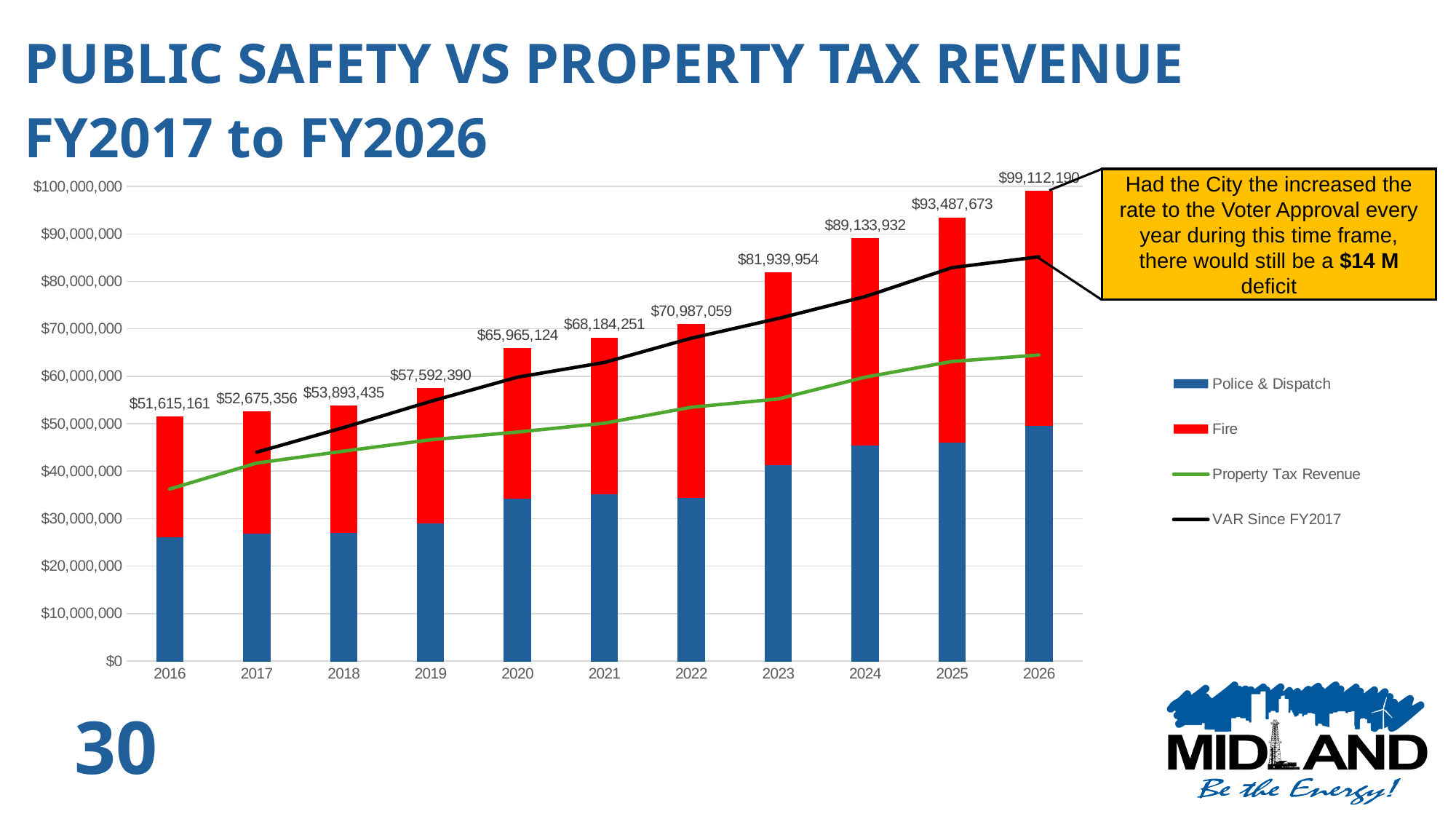
What is the difference between the labelled totals for 2026 and 2016? $47,497,029 Is the Police & Dispatch value for 2016 greater or less than $30,000,000? less Which year has the lowest labelled total? 2016 Is the Property Tax Revenue value for 2026 greater or less than $60,000,000? greater Which year has the highest labelled total? 2026 How many series does the legend list? 4 What is the difference between the labelled totals for 2021 and 2020? $2,219,127 What is the total public safety value labelled on the bar for 2026? $99,112,190 How many years are shown on the x axis? 11 Which year has a larger labelled total, 2023 or 2022? 2023 What is the total value labelled on the bar for 2020? $65,965,124 Do the labelled bar totals rise or fall from 2016 to 2026? rise